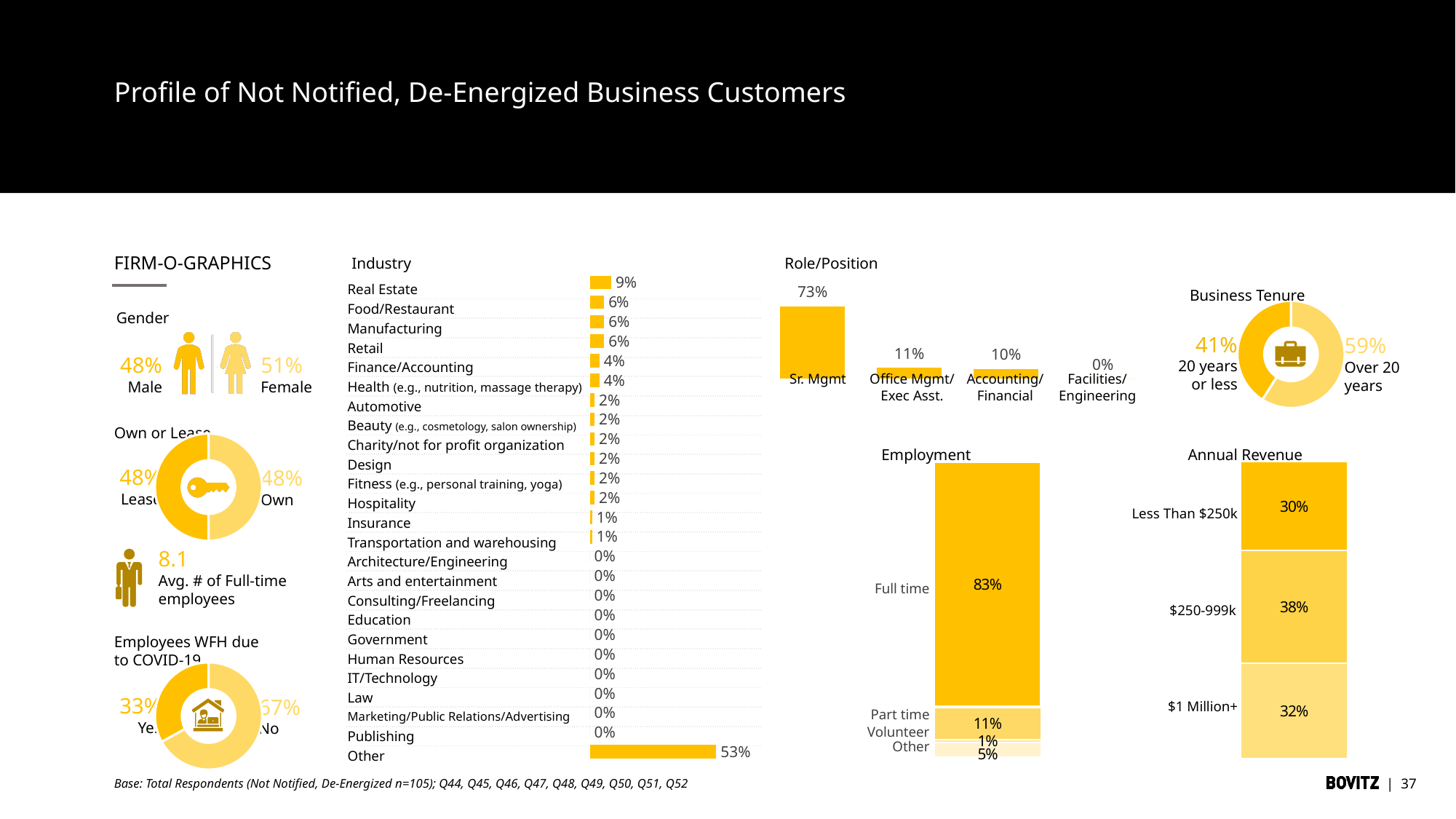
In the Business Tenure donut chart, what share is shown for Over 20 years? 59% In the Annual Revenue chart, what is the total of the three segments? 100% In the Industry chart, what is the difference between Other and Real Estate? 44% In the Industry chart, which category has the highest value? Other In the Role/Position chart, how many categories are shown? 4 In the Role/Position chart, what percentage is shown for Sr. Mgmt? 73% In the Employees WFH due to COVID-19 donut chart, which is larger, Yes or No? No In the Role/Position chart, which category has the lowest value? Facilities/Engineering In the Industry chart, what percentage is shown for Real Estate? 9% In the Employment chart, what percentage is shown for Full time? 83% In the Employment chart, what is the difference between Full time and Part time? 72% In the Annual Revenue chart, which revenue band has the largest value? $250-999k